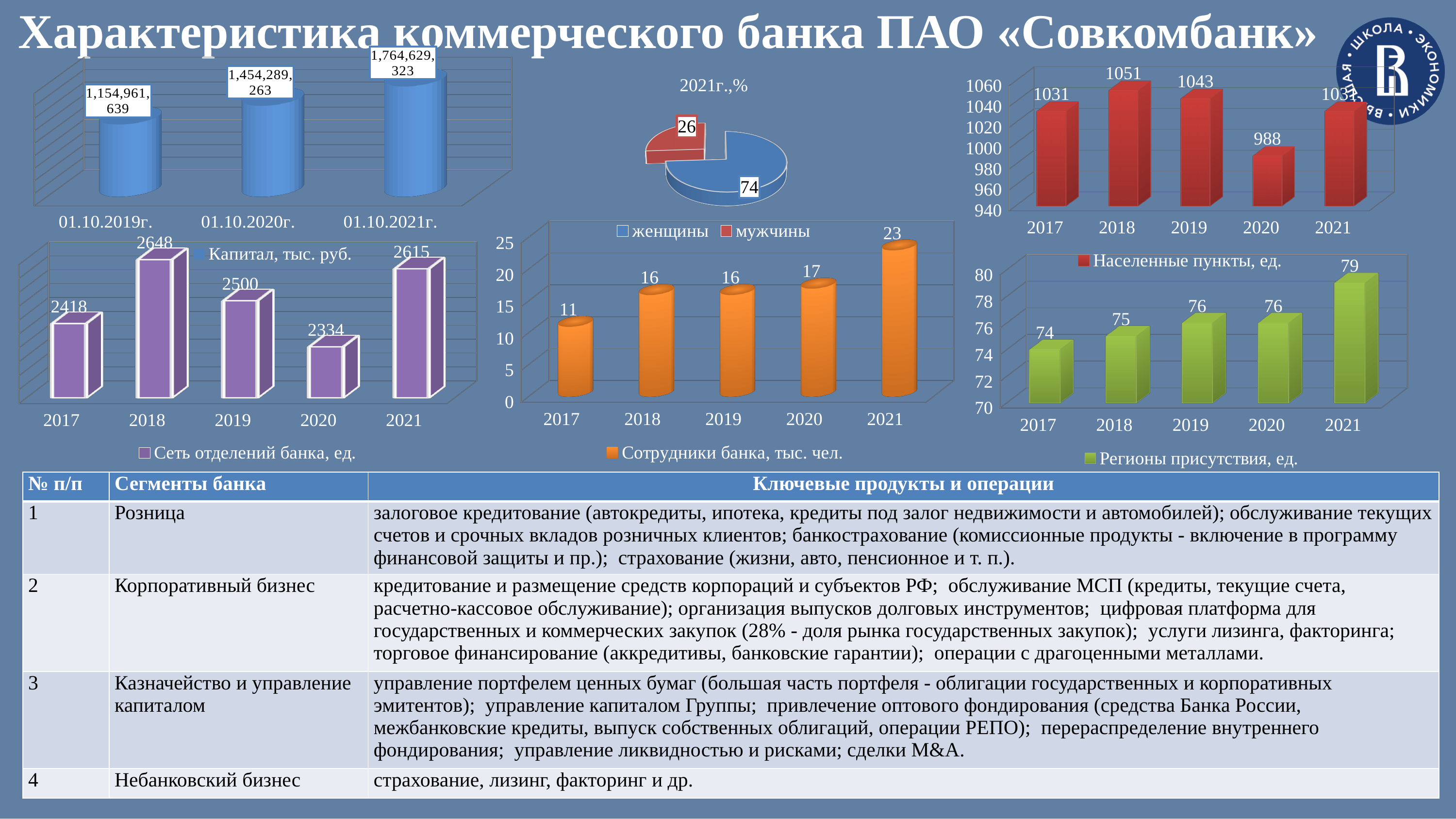
In the 'Капитал, тыс. руб.' chart, what is the value for 01.10.2021г.? 1,764,629,323 In the 'Населенные пункты, ед.' chart, what is the value for 2020? 988 In the 'Сотрудники банка, тыс. чел.' chart, what is the value for 2021? 23 In the 'Сеть отделений банка, ед.' chart, what is the value for 2018? 2648 In the 'Сотрудники банка, тыс. чел.' chart, which year has the highest value? 2021 In the pie chart titled '2021г.,%', what share is shown for мужчины? 26 In the 'Сеть отделений банка, ед.' chart, which year has the lowest value? 2020 In the 'Капитал, тыс. руб.' chart, how many bars are plotted? 3 In the 'Населенные пункты, ед.' chart, which is larger, the value for 2018 or the value for 2019? 2018 In the pie chart titled '2021г.,%', how many series does the legend list? 2 In the 'Сеть отделений банка, ед.' chart, what is the difference between the values for 2021 and 2017? 197 In the 'Регионы присутствия, ед.' chart, what is the difference between the values for 2021 and 2017? 5